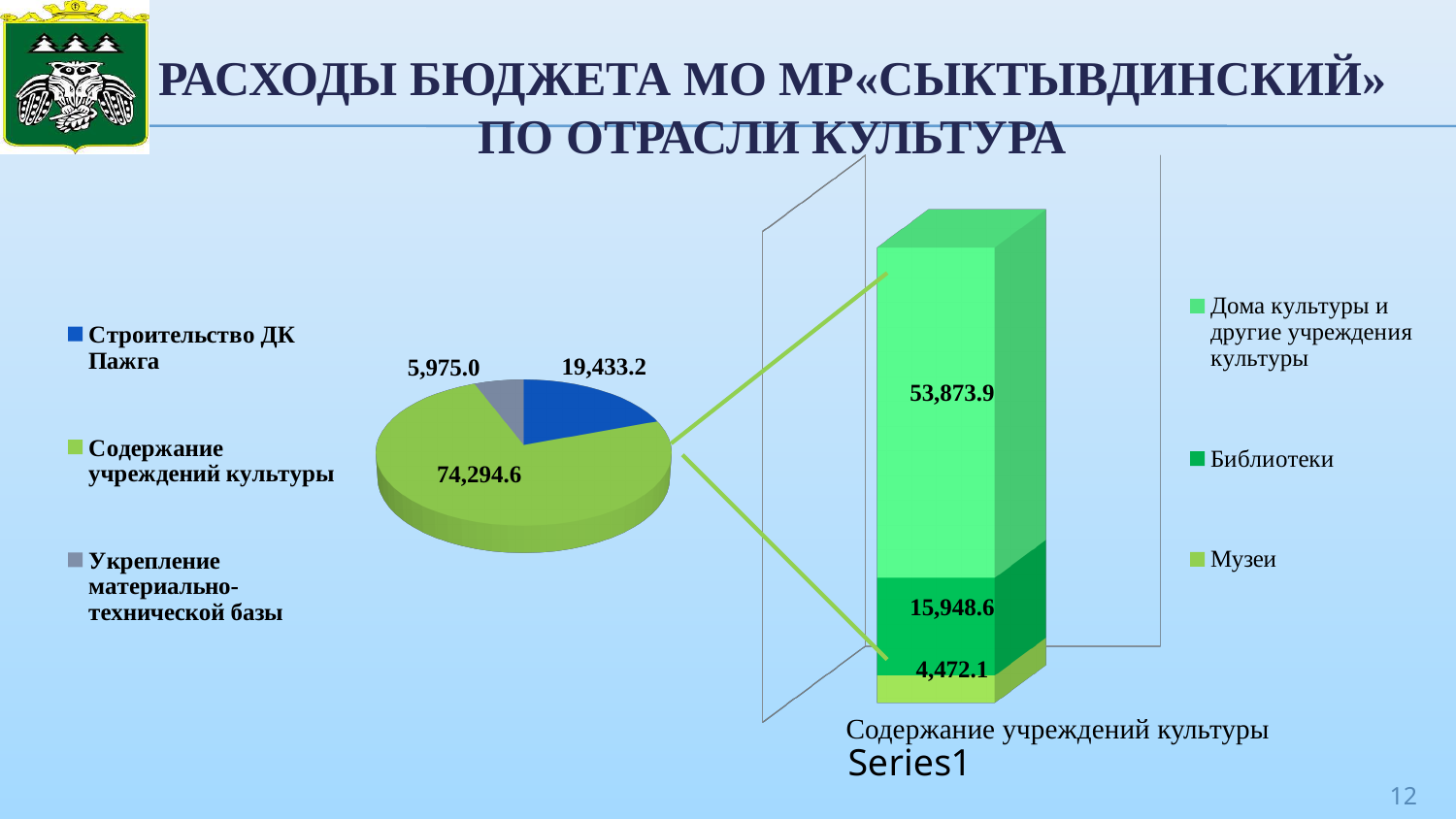
On the stacked bar chart, what is the value for Библиотеки? 15,948.6 On the stacked bar chart, what is the total of the bar Содержание учреждений культуры? 74,294.6 On the stacked bar chart, what is the value for Музеи? 4,472.1 On the stacked bar chart, what is the difference between Дома культуры и другие учреждения культуры and Библиотеки? 37,925.3 What type of chart is shown on the right side of the slide? Stacked bar chart How many series does the legend of the stacked bar chart list? 3 On the pie chart, which category has the smallest value? Укрепление материально-технической базы On the pie chart, what is the difference between Содержание учреждений культуры and Строительство ДК Пажга? 54,861.4 On the pie chart, what is the value for Содержание учреждений культуры? 74,294.6 How many slices does the pie chart have? 3 On the pie chart, what is the value for Строительство ДК Пажга? 19,433.2 On the stacked bar chart, which segment is the largest? Дома культуры и другие учреждения культуры